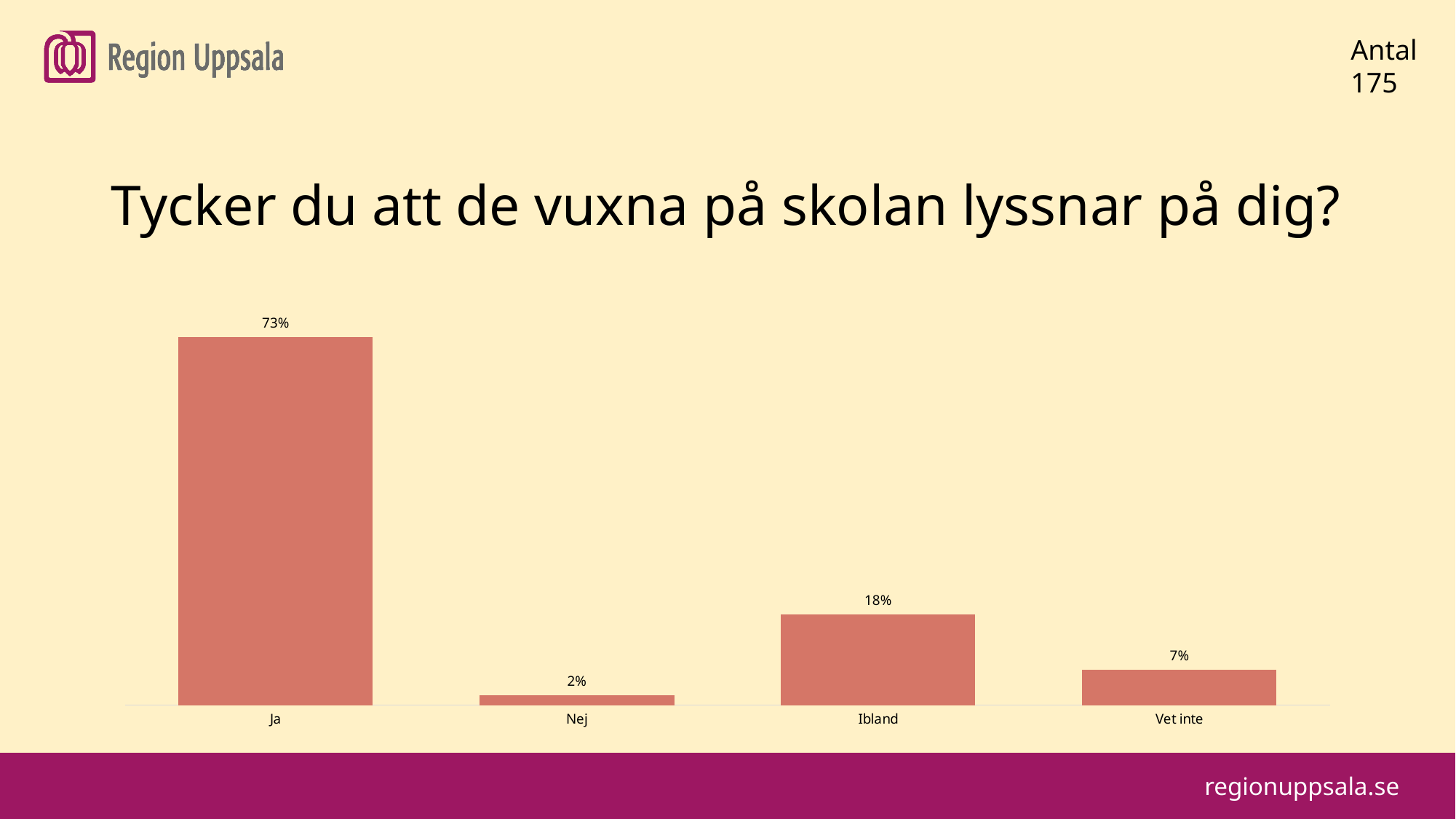
What kind of chart is shown on the slide? Bar chart How many categories are shown on the x axis? 4 Which category has the lowest value? Nej What is the value for Vet inte? 7% What is the value for Ibland? 18% What is the title of the chart? Tycker du att de vuxna på skolan lyssnar på dig? Which category has the highest value? Ja What is the value for Ja? 73% What is the difference between the values for Ibland and Vet inte? 11% What is the difference between the values for Ja and Ibland? 55% Which is larger, the value for Ibland or the value for Vet inte? Ibland What is the value for Nej? 2%